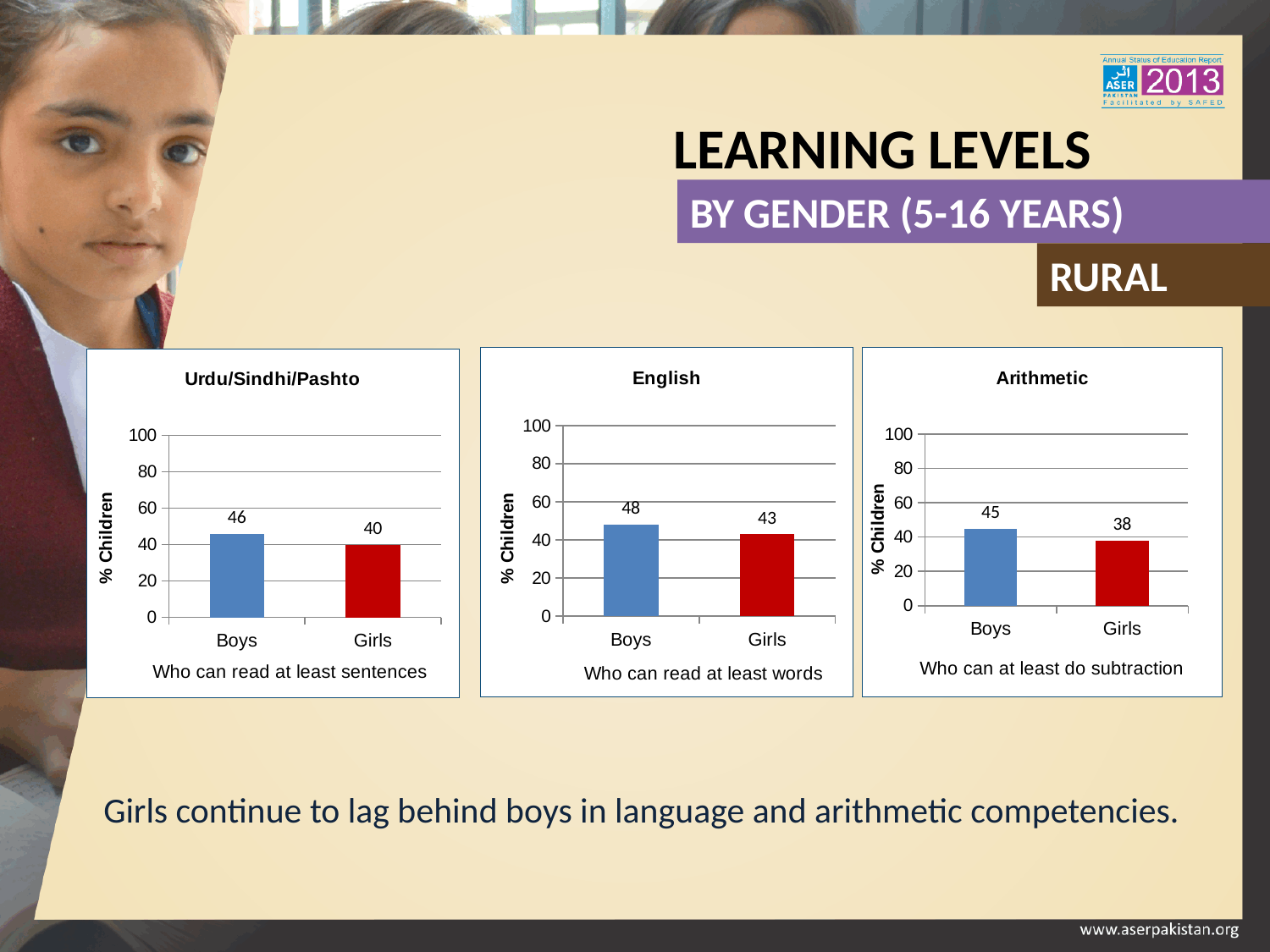
In the English chart, which category has the lower value? Girls In the Arithmetic chart, what is the value for Girls? 38 In the Urdu/Sindhi/Pashto chart, what is the difference between the values for Boys and Girls? 6 In the Urdu/Sindhi/Pashto chart, what is the value for Boys? 46 In the Arithmetic chart, which category has the higher value? Boys In the English chart, is the value for Boys or Girls larger? Boys In the Urdu/Sindhi/Pashto chart, what is the value for Girls? 40 What kind of chart is the Arithmetic chart? bar chart In the Arithmetic chart, what is the difference between the values for Boys and Girls? 7 In the Arithmetic chart, is the value for Girls greater or less than 40? less In the English chart, what is the value for Boys? 48 How many categories are shown in the English chart? 2